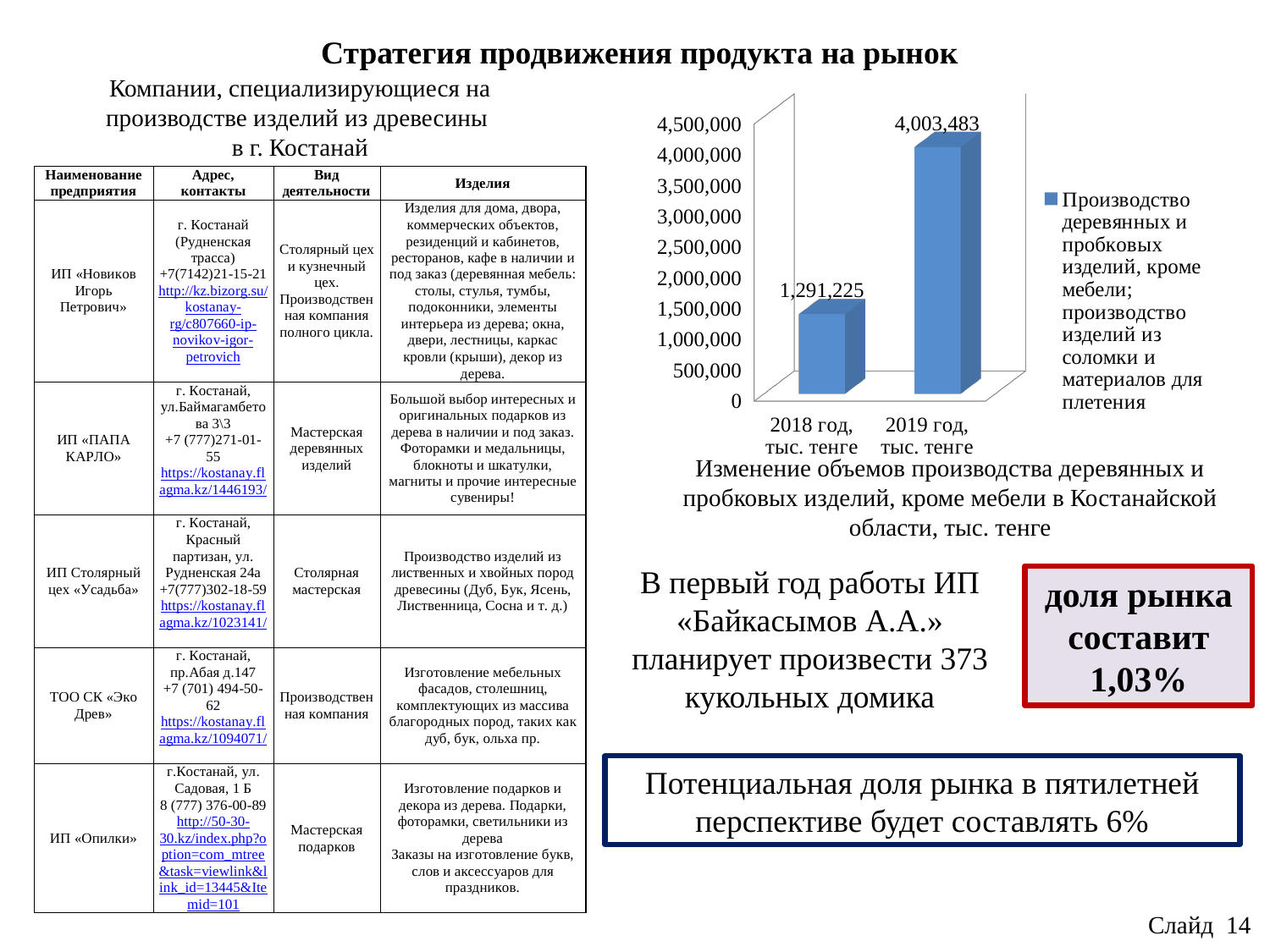
Is the value for 2018 год greater or less than 1,500,000? less How many categories (bars) are shown in the chart? 2 Which year has the highest value in the chart? 2019 год What type of chart is shown on the slide? bar chart Which year has the lowest value in the chart? 2018 год Which is larger in the chart: the value for 2018 год or for 2019 год? 2019 год What is the difference between the 2019 and 2018 values in the chart? 2,712,258 What is the value for 2018 год, тыс. тенге in the chart? 1,291,225 What is the value for 2019 год, тыс. тенге in the chart? 4,003,483 Do the values in the chart rise or fall from 2018 to 2019? rise Is the value for 2019 год greater or less than 3,500,000? greater How many series does the chart legend list? 1